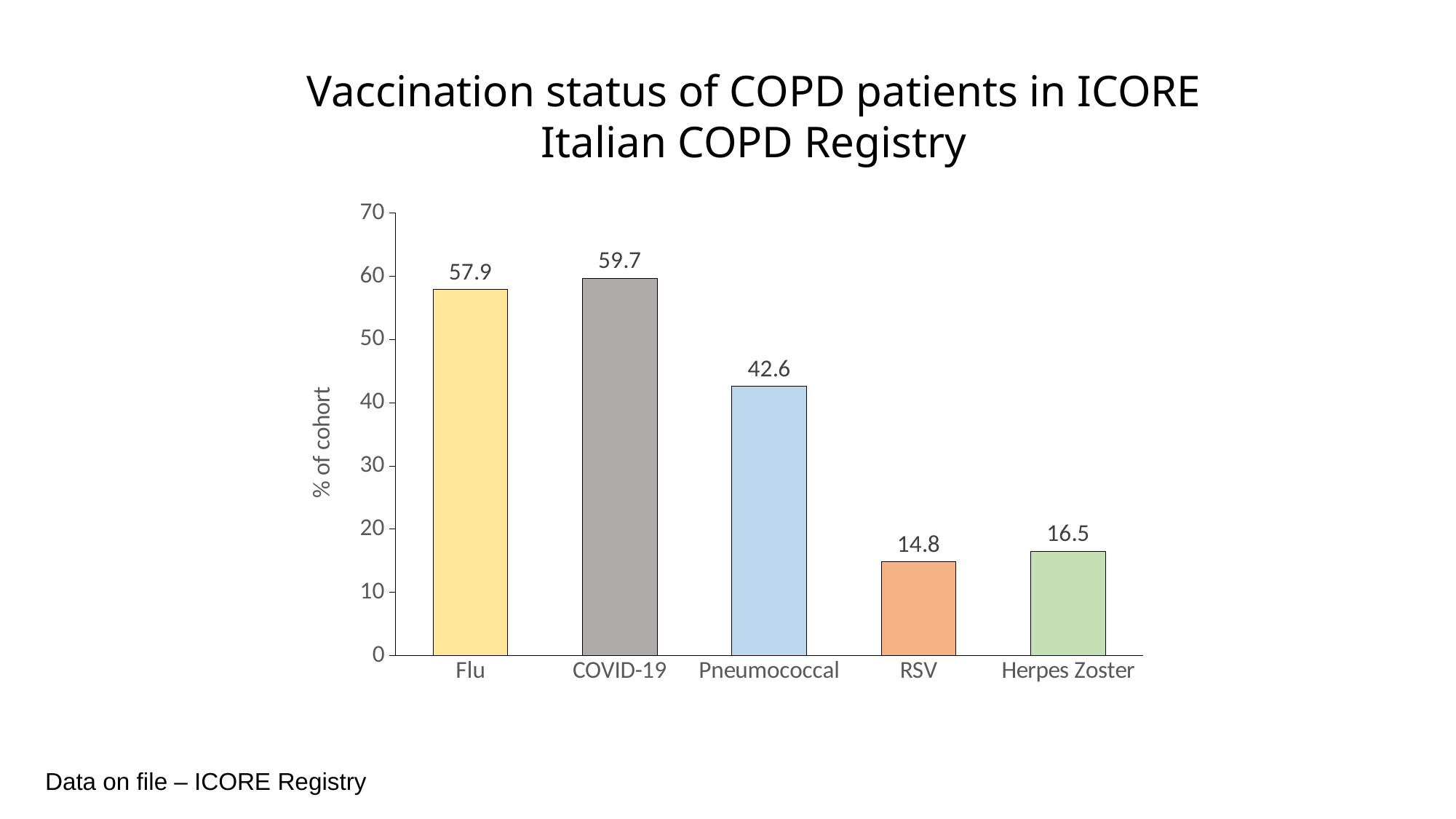
What is the difference between the values for COVID-19 and Pneumococcal? 17.1 Which is larger, the value for Flu or the value for Pneumococcal? Flu What is the value for Flu? 57.9 What kind of chart is shown on the slide? Bar chart How many categories are shown on the x axis? 5 What is the value for Herpes Zoster? 16.5 What is the value for RSV? 14.8 Which category has the highest value? COVID-19 Which category has the lowest value? RSV What is the label of the y axis? % of cohort What is the value for Pneumococcal? 42.6 What is the difference between the values for Herpes Zoster and RSV? 1.7